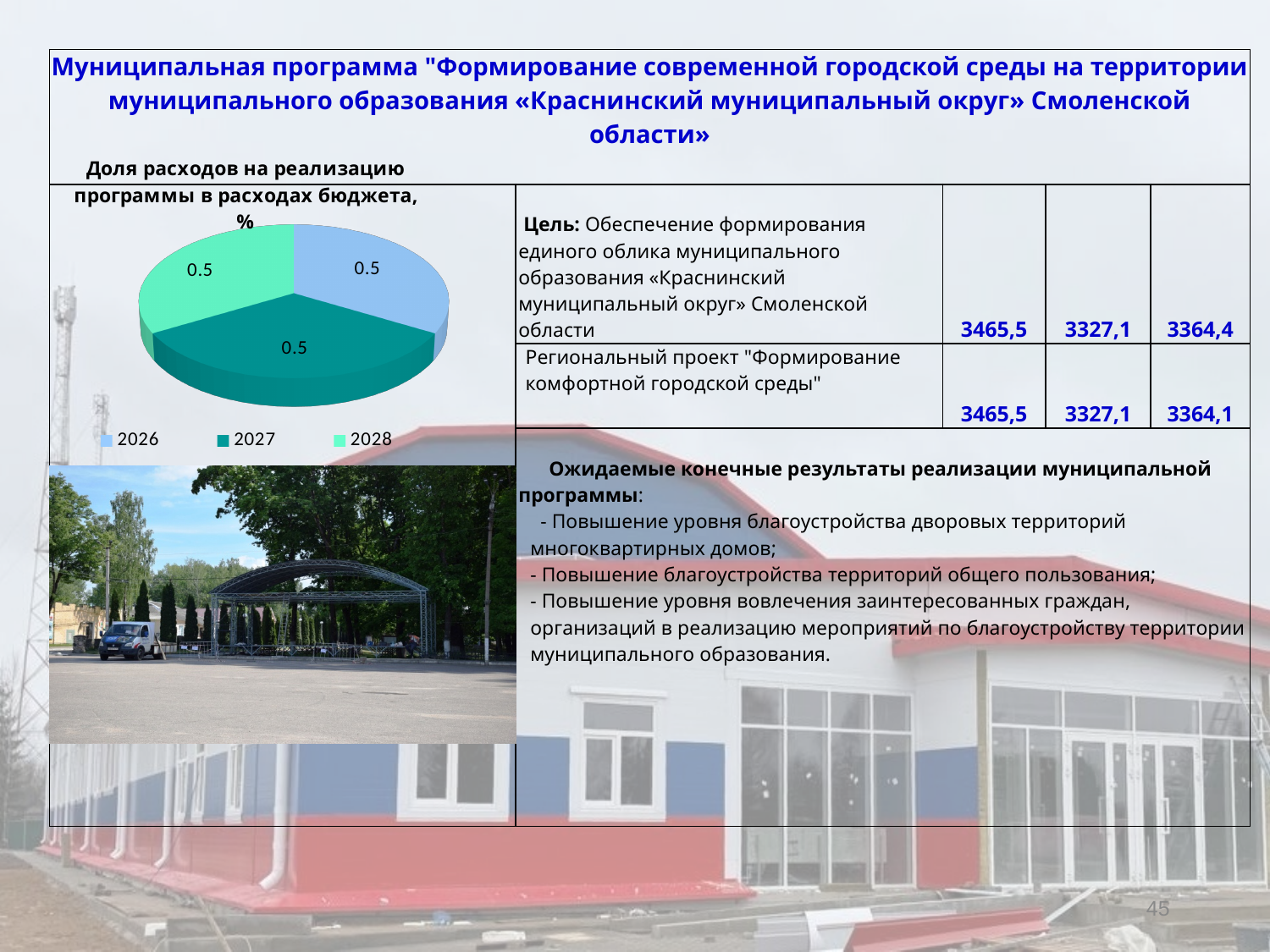
What type of chart is shown on the slide? pie chart What value is shown for 2028 in the pie chart? 0.5 How many slices does the pie chart have? 3 What is the sum of the three values shown in the pie chart? 1.5 What value is shown for 2026 in the pie chart? 0.5 What is the title of the pie chart? Доля расходов на реализацию программы в расходах бюджета, % What value is shown for 2027 in the pie chart? 0.5 Which years are listed in the legend of the pie chart? 2026, 2027, 2028 Are the values for 2026 and 2027 in the pie chart equal? yes What is the difference between the values for 2027 and 2028 in the pie chart? 0 How many entries does the legend of the pie chart list? 3